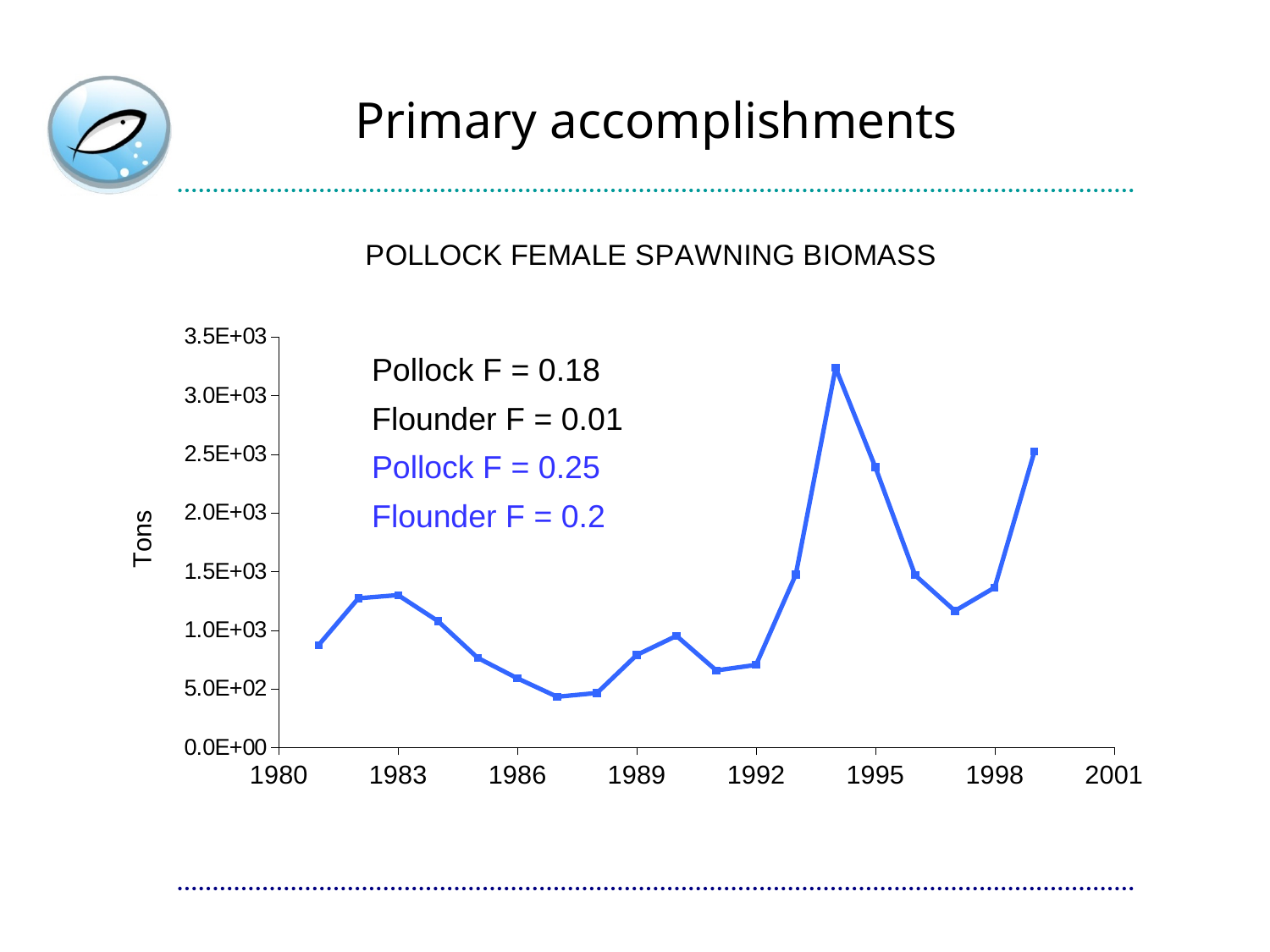
Does the biomass rise or fall between 1997 and 1999? rise Is the value for 1995 greater or less than 2.0E+03? greater What is the title of the chart? POLLOCK FEMALE SPAWNING BIOMASS Is the value for 1987 greater or less than 5.0E+02? less Is the value for 1994 greater or less than 3.0E+03? greater What is the label on the y axis of the chart? Tons What kind of chart is shown on the slide? line chart In which year does the pollock female spawning biomass reach its highest value? 1994 Which year has the larger value, 1994 or 1999? 1994 Does the biomass rise or fall between 1994 and 1997? fall Which year has the larger value, 1983 or 1986? 1983